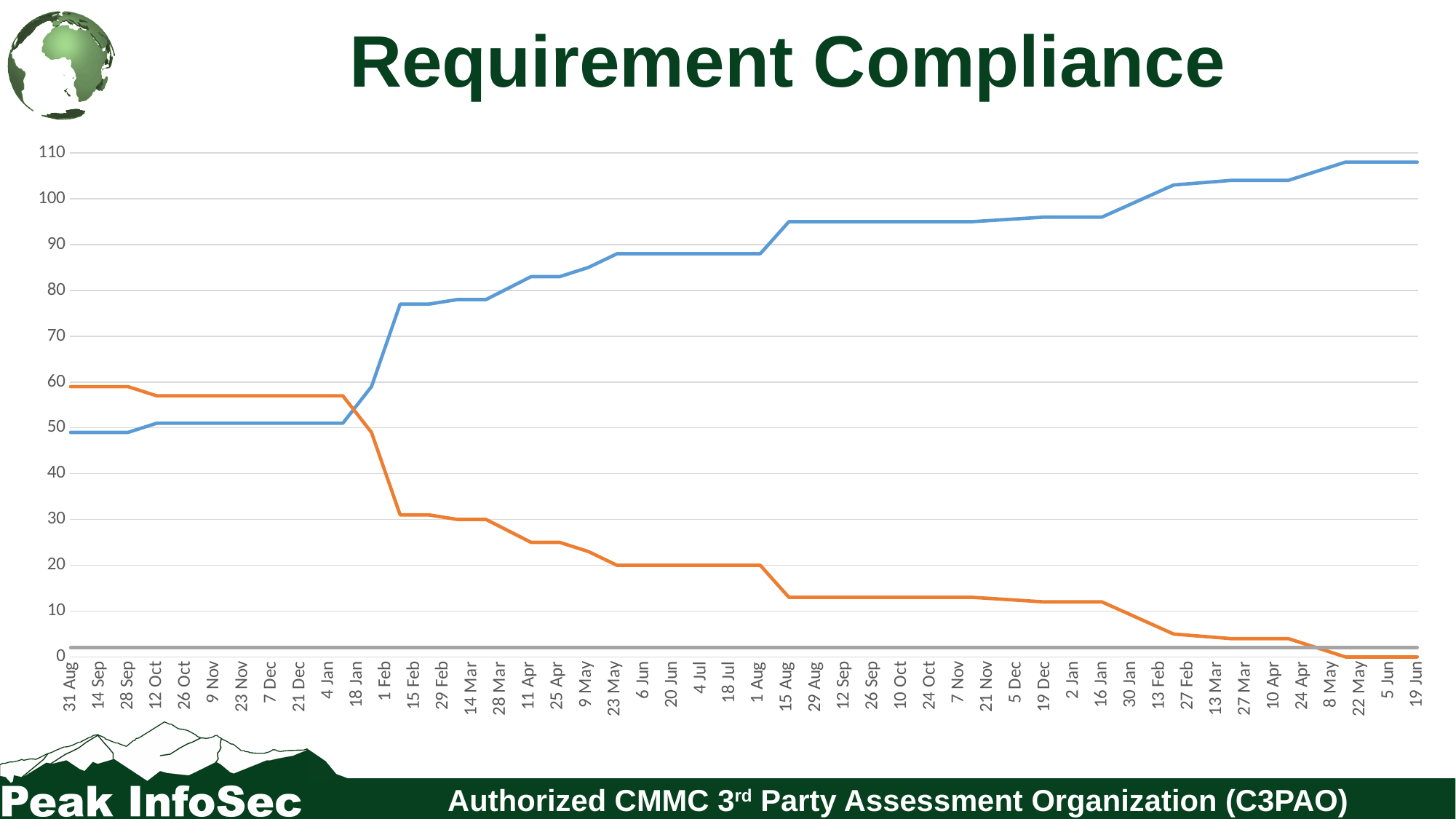
Is the value of the orange line at 15 Aug greater or less than 20? less What is the title of the chart? Requirement Compliance Does the orange line rise or fall from 31 Aug to 19 Jun? fall Does the blue line rise or fall from 31 Aug to 19 Jun? rise Is the value of the blue line at 19 Jun greater or less than 100? greater Is the value of the orange line at 31 Aug greater or less than 50? greater At 31 Aug, which line is higher, the blue line or the orange line? orange line How many lines are plotted on the chart? 3 What kind of chart is shown on the slide? line chart How many dates are labelled along the x axis? 48 At 19 Jun, which line is higher, the blue line or the orange line? blue line